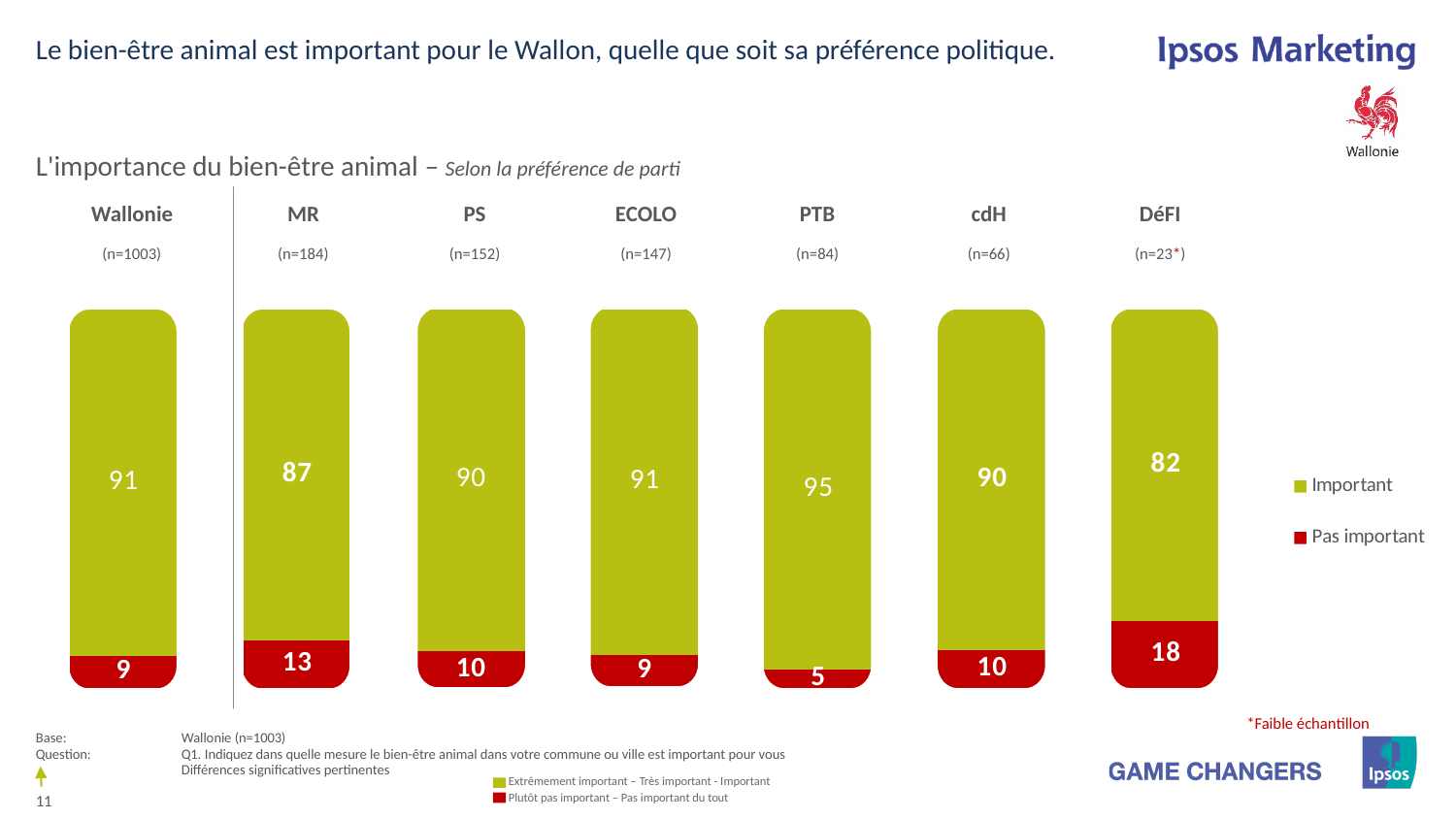
What is the 'Pas important' value for DéFI? 18 What is the total of the stacked bar for cdH? 100 Which category has the lowest 'Pas important' value? PTB Which party has the lowest 'Important' value? DéFI What is the difference between the 'Pas important' values for DéFI and Wallonie? 9 How many categories are shown on the chart? 7 Which is larger, the 'Important' value for MR or for PS? PS What is the 'Important' value for MR? 87 Which party has the highest 'Important' value? PTB What kind of chart is shown on the slide? Stacked bar chart How many series does the legend list? 2 What is the 'Important' value for PTB? 95